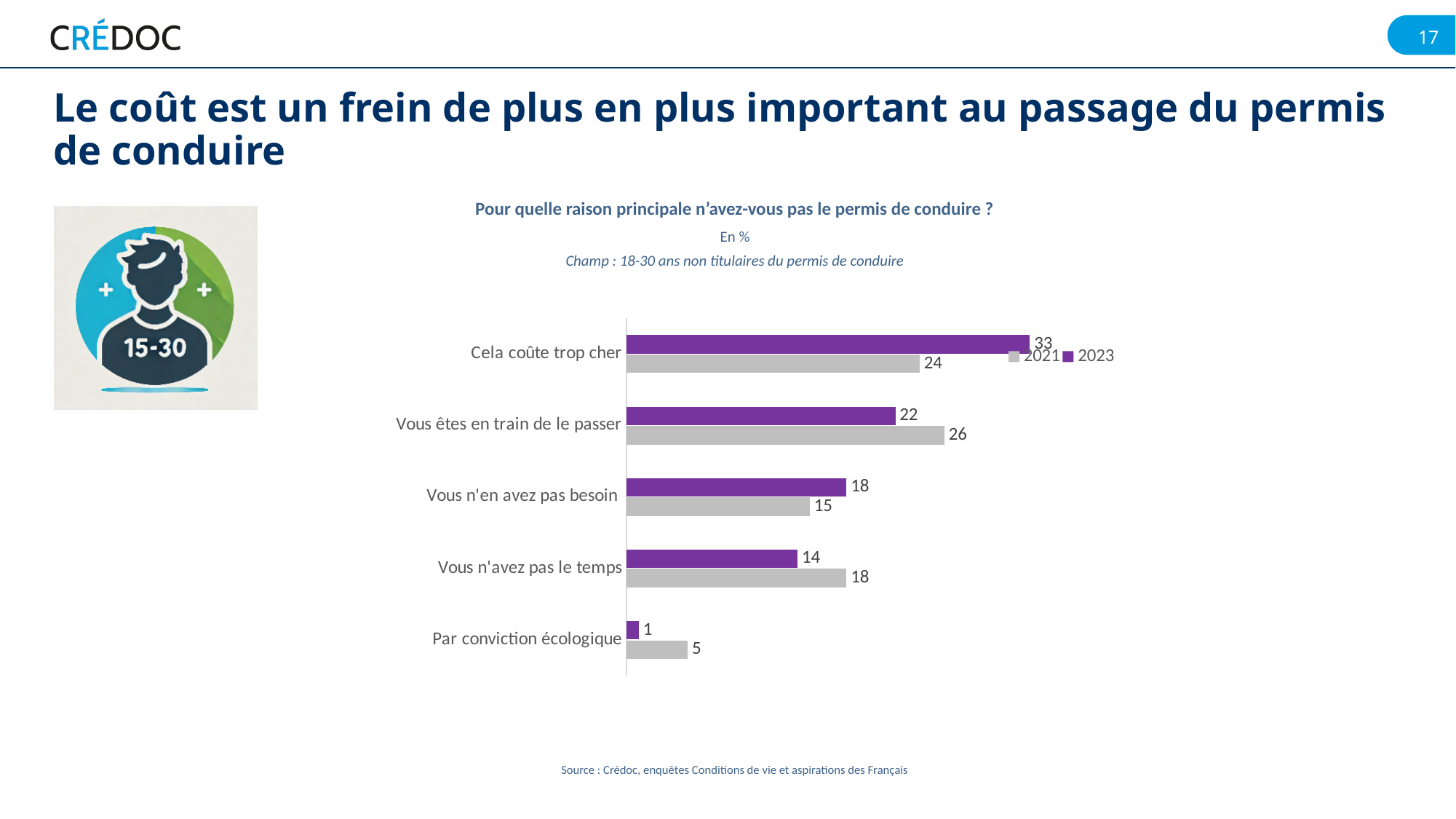
Which colour represents the 2023 series? Purple What is the difference between the 2023 and 2021 values for "Cela coûte trop cher"? 9 Which category has the lowest 2021 value? Par conviction écologique What is the 2021 value for "Vous êtes en train de le passer"? 26 What is the 2023 value for "Par conviction écologique"? 1 How many series does the legend list? 2 What is the difference between the 2021 and 2023 values for "Vous n'avez pas le temps"? 4 What is the 2023 value for "Cela coûte trop cher"? 33 Which category has the highest 2023 value? Cela coûte trop cher What kind of chart is shown on the slide? Bar chart How many categories are shown on the chart? 5 For "Vous n'en avez pas besoin", which year has the larger value, 2021 or 2023? 2023